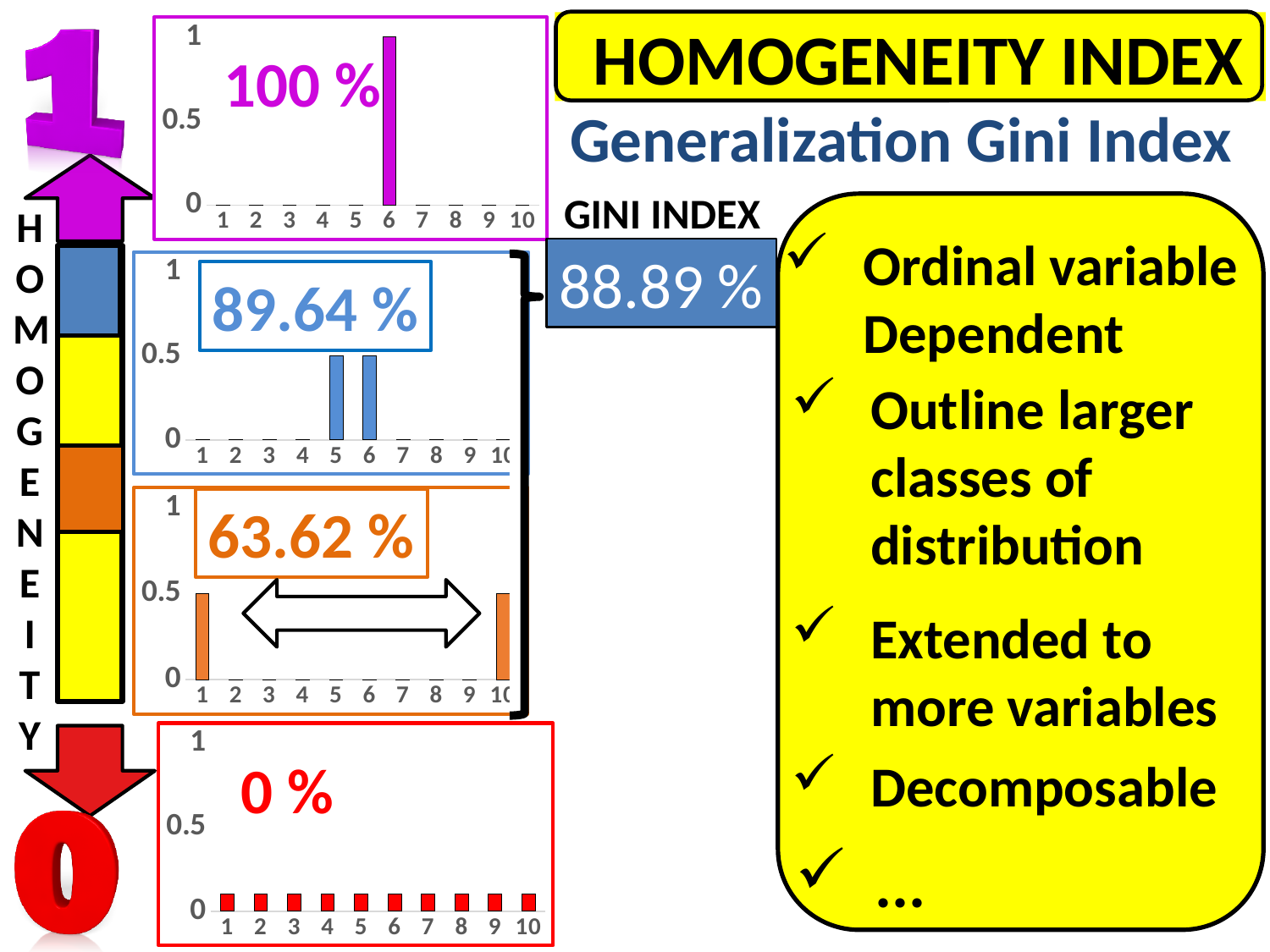
In the chart labelled 63.62 %, is the value for category 5 greater or less than 0.5? less What kind of chart is the top chart labelled 100 %? bar chart In the bottom chart labelled 0 %, how many bars are plotted? 10 Which is larger: the bar at category 6 in the top chart labelled 100 %, or the bar at category 6 in the chart labelled 89.64 %? the bar in the top chart labelled 100 % In the chart labelled 63.62 %, which categories have bars? 1 and 10 In the chart labelled 89.64 %, which categories have bars? 5 and 6 In the bottom chart labelled 0 %, is the value for category 3 greater or less than 0.5? less In the top chart labelled 100 %, how many categories are shown on the x axis? 10 In the chart labelled 89.64 %, what is the value of the bar at category 5? 0.5 In the top chart labelled 100 %, which category has the only bar? 6 In the top chart labelled 100 %, what is the value of the bar at category 6? 1 In the chart labelled 63.62 %, what is the value of the bar at category 10? 0.5